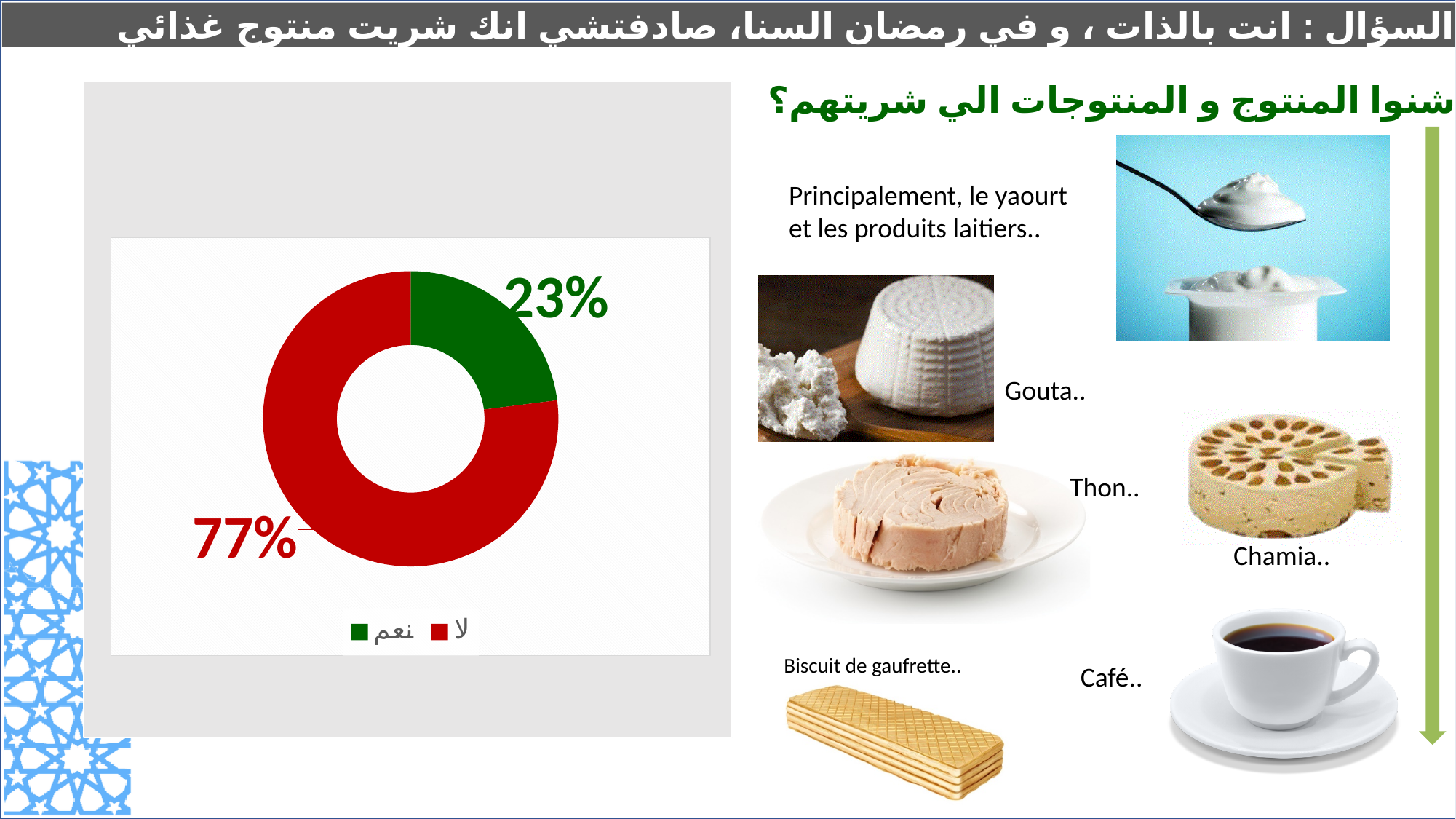
What is the combined percentage of the two slices in the donut chart? 100% What percentage is shown for the green slice labelled "نعم"? 23% Which category has the smallest share of the donut chart? نعم Which category has the largest share of the donut chart? لا What colour is the slice labelled "نعم" in the donut chart? Green How many entries does the chart legend list? 2 What colour is the slice labelled "لا" in the donut chart? Red What kind of chart is shown on the left of the slide? Donut chart What percentage is shown for the red slice labelled "لا"? 77% How many slices does the donut chart have? 2 What is the difference in percentage points between the "لا" slice and the "نعم" slice? 54 Which slice is larger, "نعم" or "لا"? لا